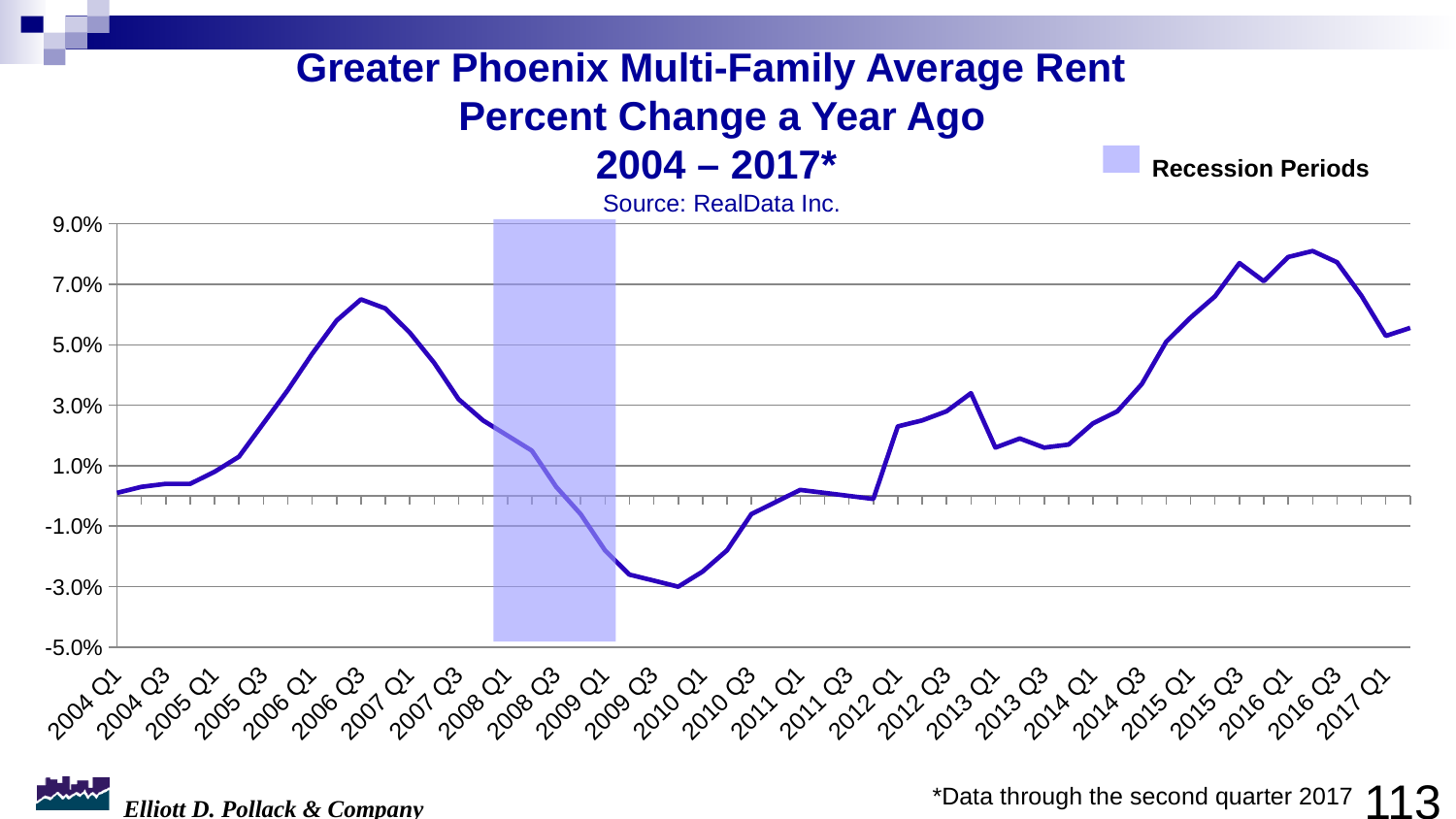
Which is larger, the value for 2005 Q1 or the value for 2013 Q1? 2013 Q1 Which is larger, the value for 2006 Q3 or the value for 2016 Q3? 2016 Q3 Is the value for 2010 Q1 greater or less than -1.0%? less Is the value for 2006 Q3 greater or less than 5.0%? greater Do the values rise or fall between 2014 Q1 and 2016 Q3? rise Is the value for 2004 Q1 greater or less than 1.0%? less What does the shaded area on the chart represent, according to the legend? Recession Periods What kind of chart is shown on the slide? line chart Do the values rise or fall between 2006 Q3 and 2010 Q1? fall